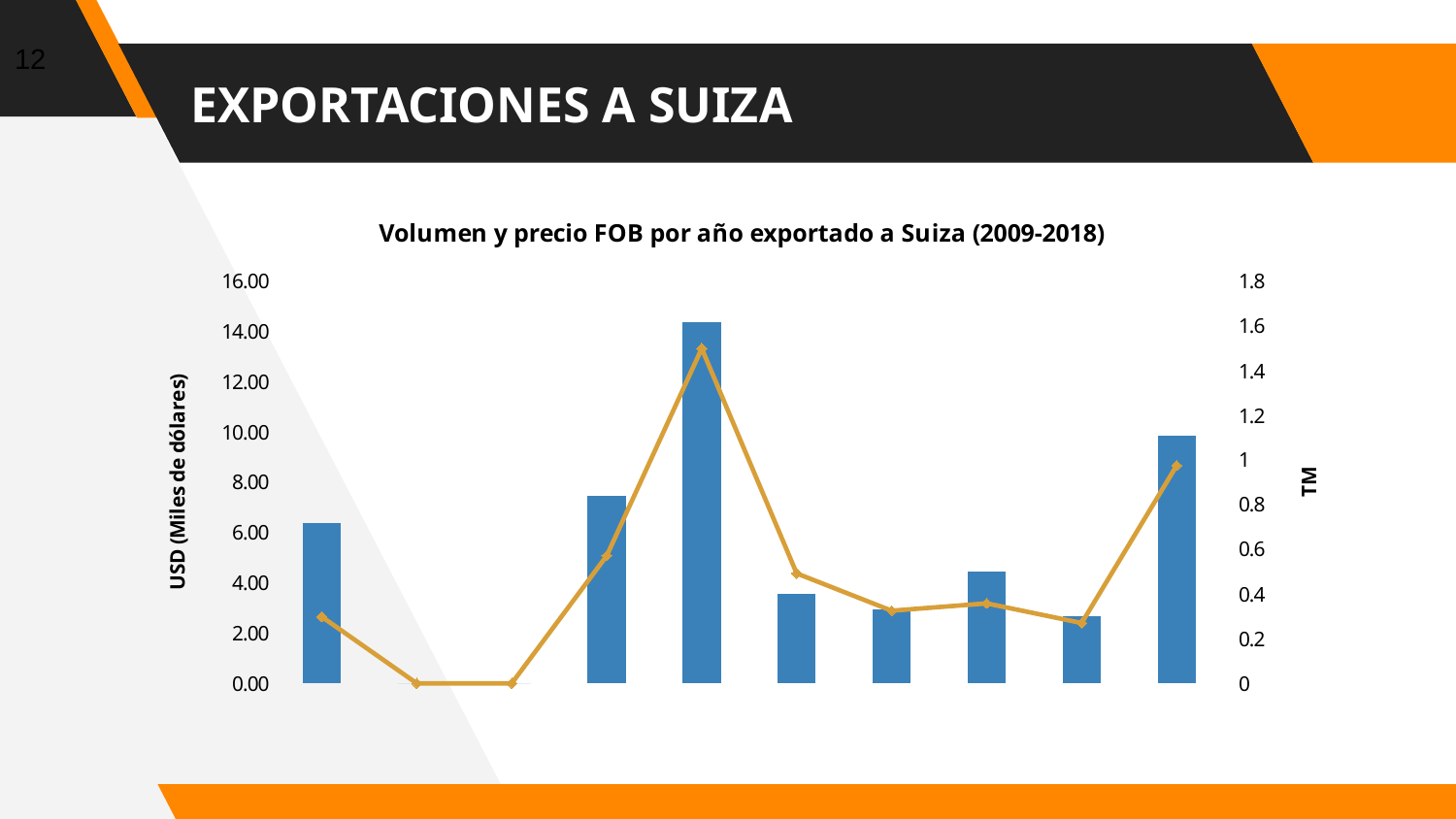
Is the value of the tallest bar greater or less than 12.00 on the left axis? greater Which bar is the tallest, counting positions from the left? The fifth How many data points does the line series have? 10 What type of chart is shown on the slide? Combination bar and line chart What is the label of the left vertical axis? USD (Miles de dólares) Does the line rise or fall between its fifth and sixth points? Fall Which is taller, the fifth bar from the left or the last bar on the right? The fifth bar Is the value of the last bar on the right greater or less than 8.00 on the left axis? greater What is the title of the chart? Volumen y precio FOB por año exportado a Suiza (2009-2018) Is the value of the first bar on the left greater or less than 8.00 on the left axis? less What is the maximum value shown on the right vertical axis? 1.8